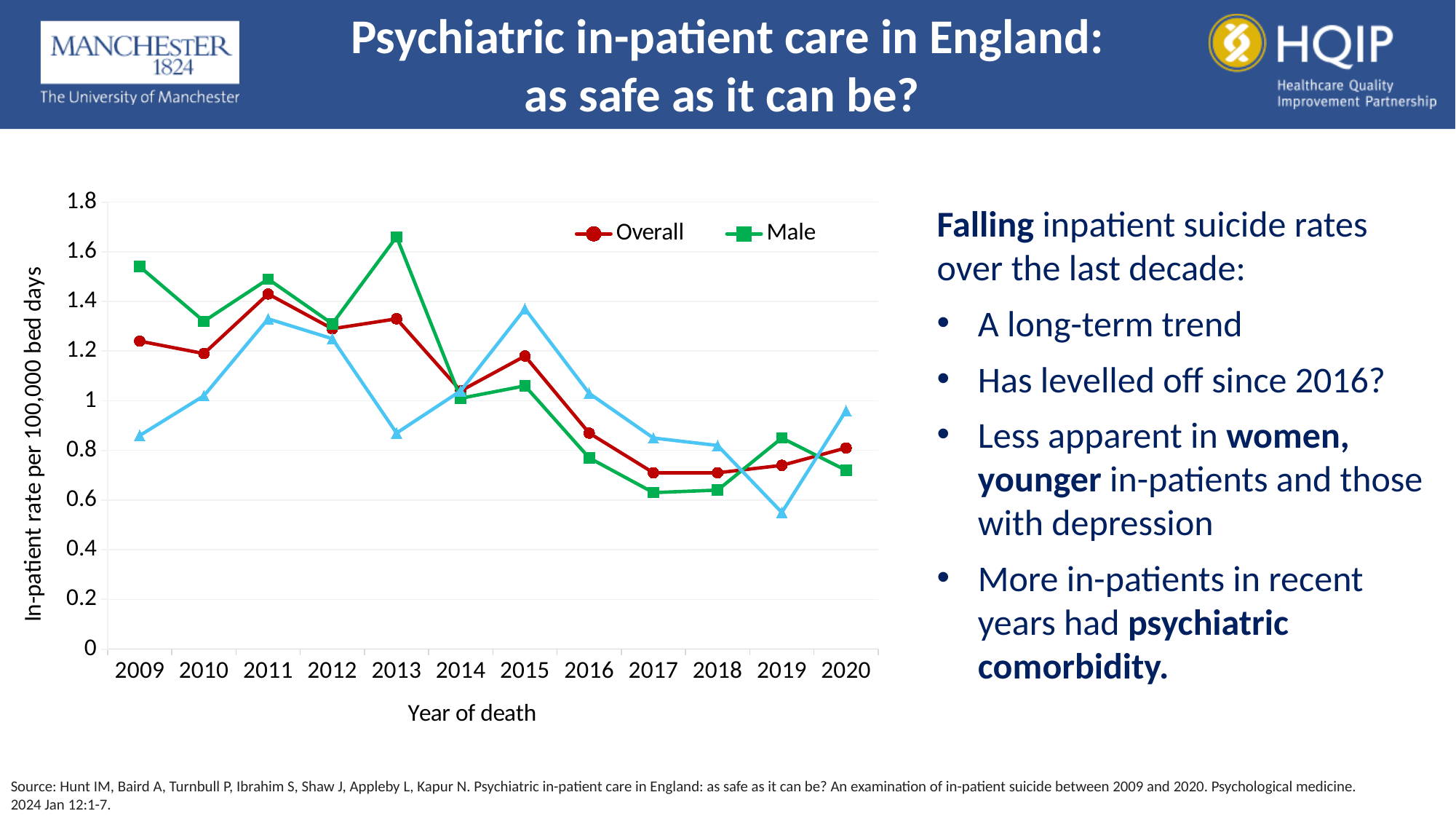
Is the Overall value for 2014 greater or less than 1.2? less How many series does the chart's legend list? 2 In 2009, which series has the higher value, Overall or Male? Male What is the label on the chart's x axis? Year of death In which year does the Overall series reach its highest value? 2011 How many years are plotted along the x axis of the chart? 12 In which year does the Male series reach its highest value? 2013 Is the Male value for 2009 greater or less than 1.4? greater Does the Overall in-patient rate generally rise or fall from 2009 to 2020? Fall What kind of chart is shown on the slide? Line chart Is the Overall value for 2017 greater or less than 0.8? less